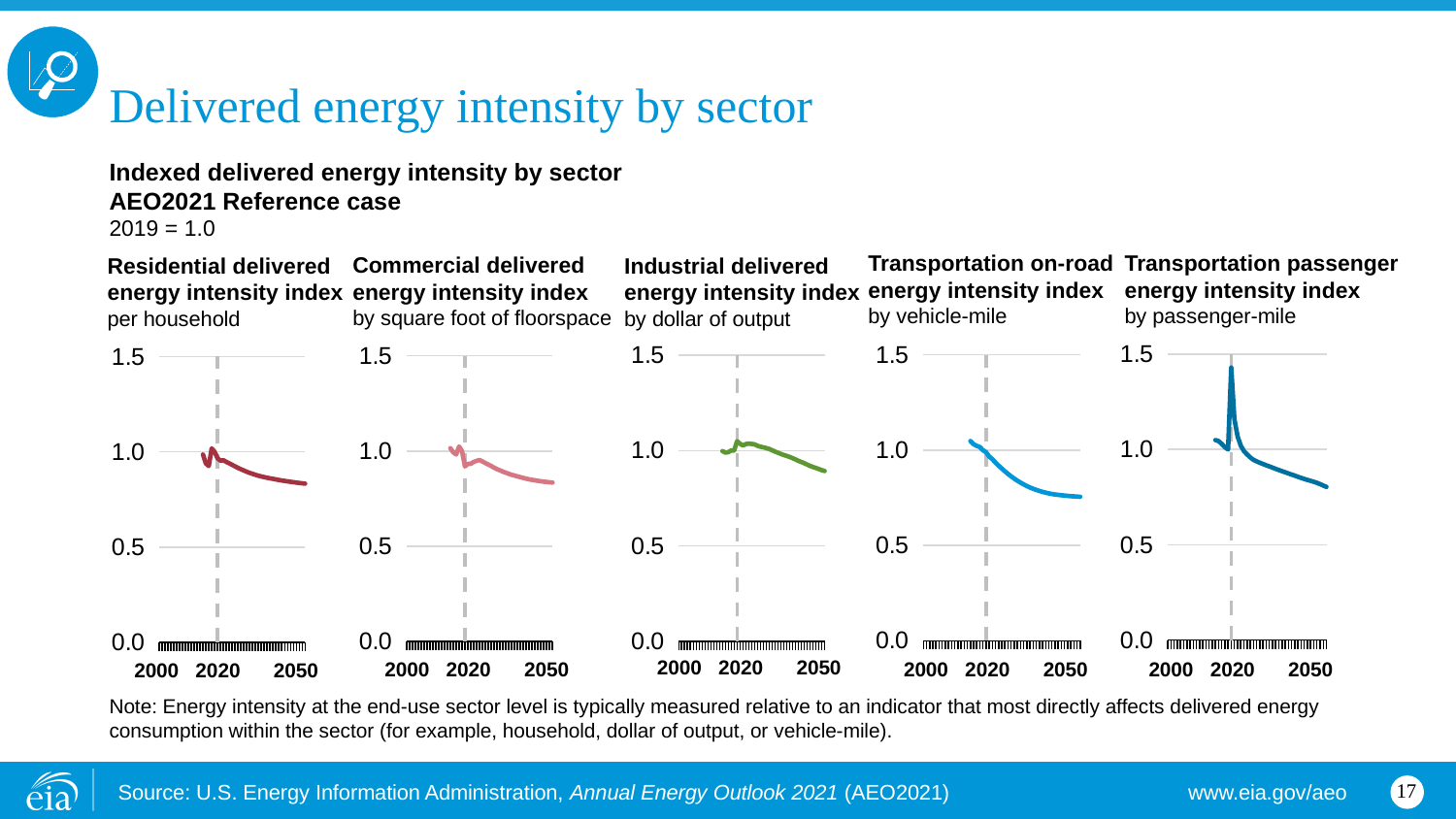
In the Transportation on-road energy intensity index chart, does the value rise or fall from 2020 to 2050? fall In the Commercial delivered energy intensity index chart, does the value rise or fall from 2020 to 2050? fall In the Transportation passenger energy intensity index chart, does the value rise or fall from 2020 to 2050? fall In the Transportation on-road energy intensity index chart, is the value in 2050 greater or less than 1.0? less In the Industrial delivered energy intensity index chart, is the value in 2050 greater or less than 1.0? less In the Residential delivered energy intensity index chart, is the value in 2050 greater or less than 0.5? greater According to the subtitle, which year is indexed to 1.0 in these charts? 2019 What kind of chart is the Residential delivered energy intensity index chart? line chart How many charts are shown on the slide? 5 What is the highest value shown on the vertical axis of the Industrial delivered energy intensity index chart? 1.5